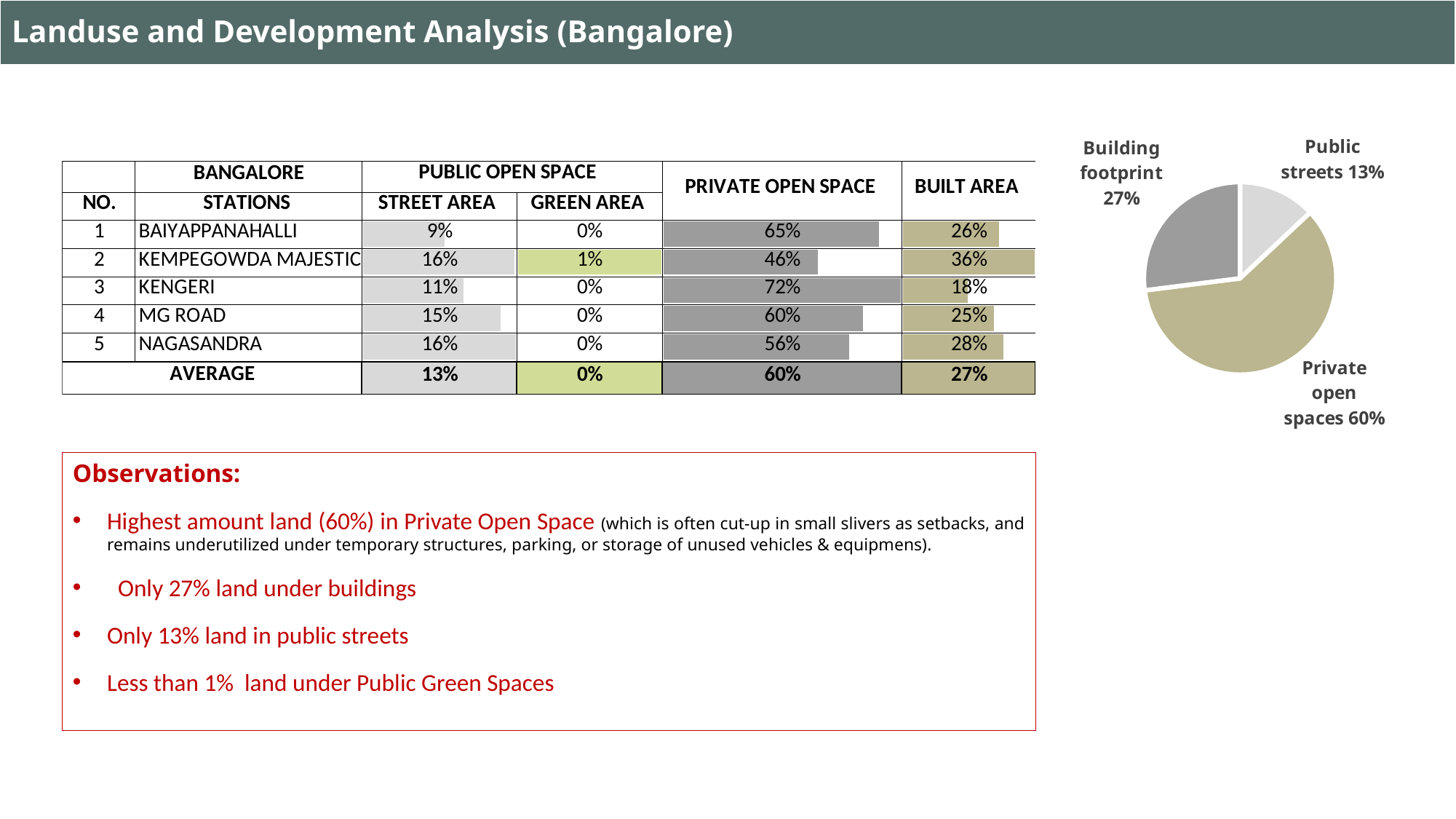
Which slice of the pie chart is the largest? Private open spaces In the pie chart, which slice is shown in the lightest grey? Public streets In the pie chart, what do the three labelled shares add up to? 100% In the pie chart, what share is labelled for Public streets? 13% How many slices does the pie chart have? 3 Which slice of the pie chart is the smallest? Public streets In the pie chart, which is larger: Building footprint or Public streets? Building footprint In the pie chart, what is the difference between the Private open spaces share and the Building footprint share? 33% In the pie chart, what is the difference between the Building footprint share and the Public streets share? 14% In the pie chart, what share is labelled for Building footprint? 27% In the pie chart, what share is labelled for Private open spaces? 60% What kind of chart is shown on the right of the slide? Pie chart